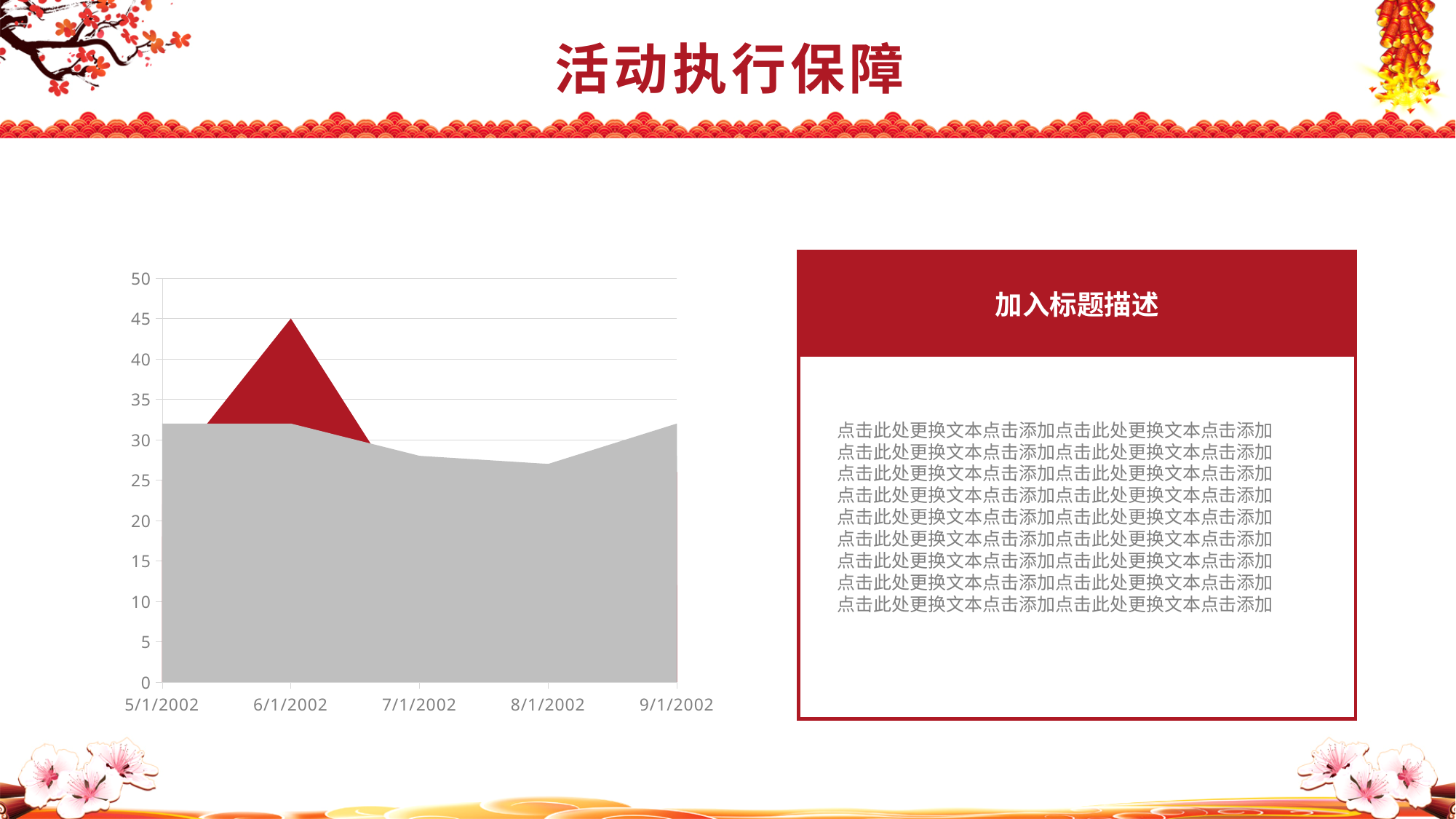
Is the value of the gray area at 5/1/2002 greater or less than 30? greater Is the value of the gray area at 9/1/2002 greater or less than 30? greater Which is larger for the gray area: the value at 5/1/2002 or the value at 8/1/2002? 5/1/2002 What kind of chart is shown on the slide? area chart Does the gray area rise or fall from 8/1/2002 to 9/1/2002? rise Is the peak of the red area at 6/1/2002 greater or less than 40? greater What is the highest value shown on the y axis of the chart? 50 At which date does the red area reach its highest point? 6/1/2002 How many dates are labelled on the x axis of the chart? 5 Does the gray area rise or fall from 6/1/2002 to 8/1/2002? fall